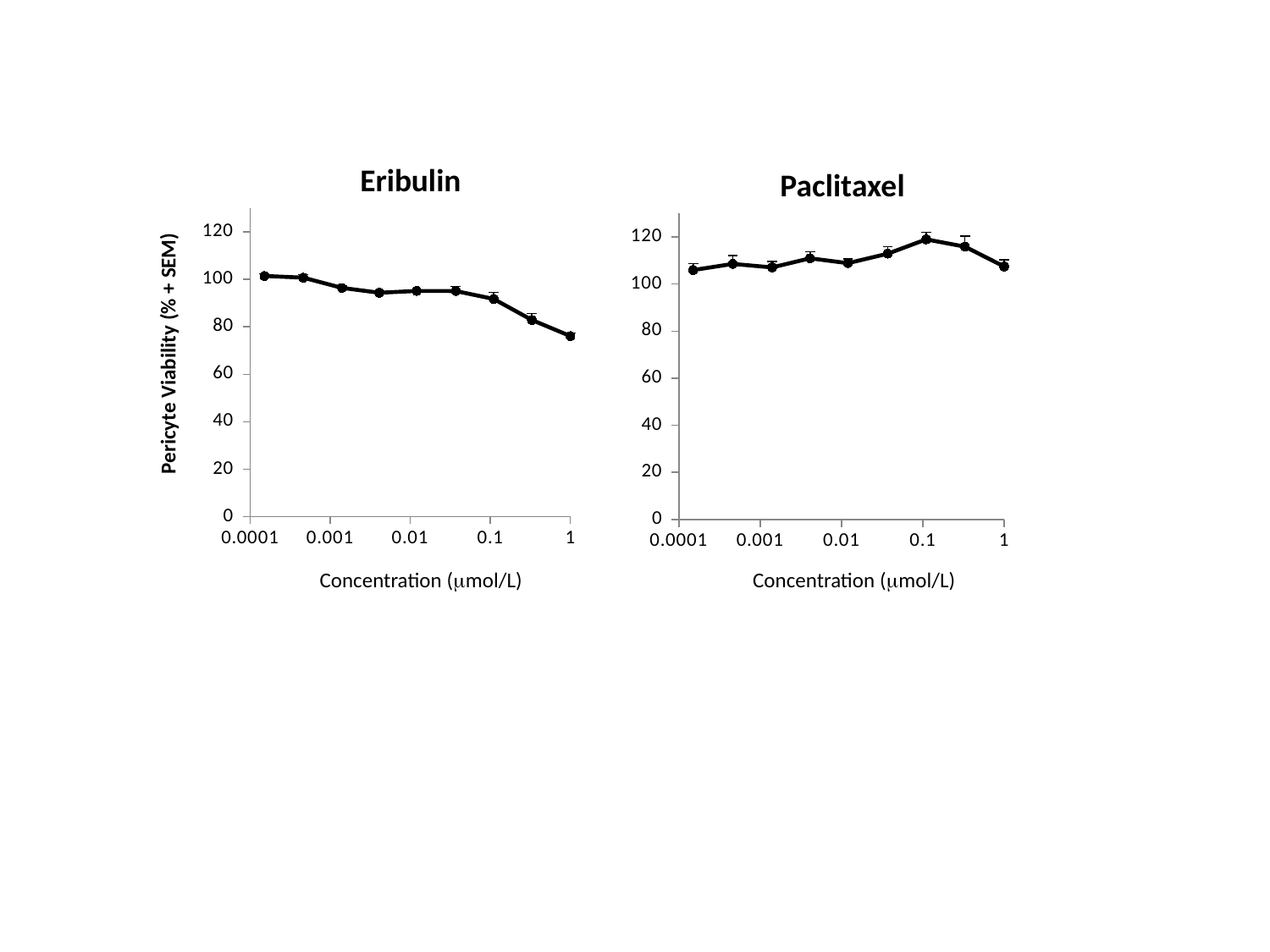
What kind of chart is the Paclitaxel chart? line chart In the Paclitaxel chart, is the value at 1 µmol/L greater or less than 100? greater In the Eribulin chart, do the values rise or fall as concentration increases along the x axis? fall What is the y-axis label shared by the two charts? Pericyte Viability (% + SEM) In the Eribulin chart, is the value at 1 µmol/L greater or less than 80? less In the Eribulin chart, at which concentration is pericyte viability lowest? 1 µmol/L In the Paclitaxel chart, is the value at 0.1 µmol/L greater or less than 100? greater What kind of chart is the Eribulin chart? line chart At 1 µmol/L, which chart shows the larger pericyte viability, Eribulin or Paclitaxel? Paclitaxel How many data points are plotted in the Eribulin chart? 9 What is the x-axis label on the Paclitaxel chart? Concentration (µmol/L)